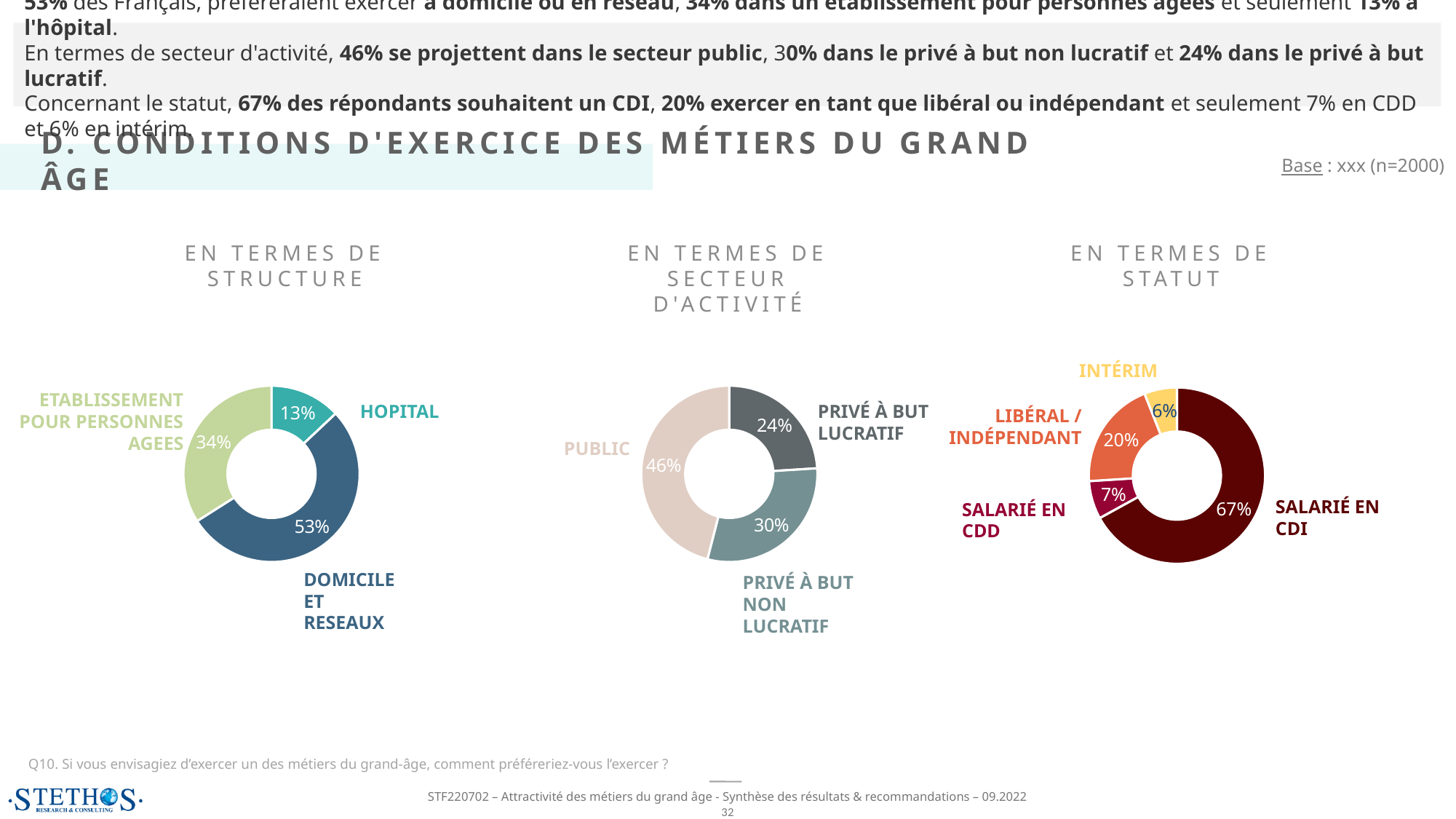
In the 'En termes de secteur d'activité' chart, which category has the smallest share? Privé à but lucratif What kind of chart is used for 'En termes de structure'? Doughnut chart In the 'En termes de statut' chart, what is the value for Libéral / indépendant? 20% In the 'En termes de structure' chart, what is the difference between Domicile et reseaux and Etablissement pour personnes agees? 19% In the 'En termes de statut' chart, what is the difference between Salarié en CDD and Intérim? 1% In the 'En termes de secteur d'activité' chart, which is larger: Privé à but non lucratif or Privé à but lucratif? Privé à but non lucratif In the 'En termes de secteur d'activité' chart, what is the value for Public? 46% In the 'En termes de statut' chart, which category has the largest share? Salarié en CDI How many charts are shown on the slide? 3 In the 'En termes de structure' chart, which category has the largest share? Domicile et reseaux How many categories does the 'En termes de statut' chart show? 4 In the 'En termes de structure' chart, what is the value for Hopital? 13%